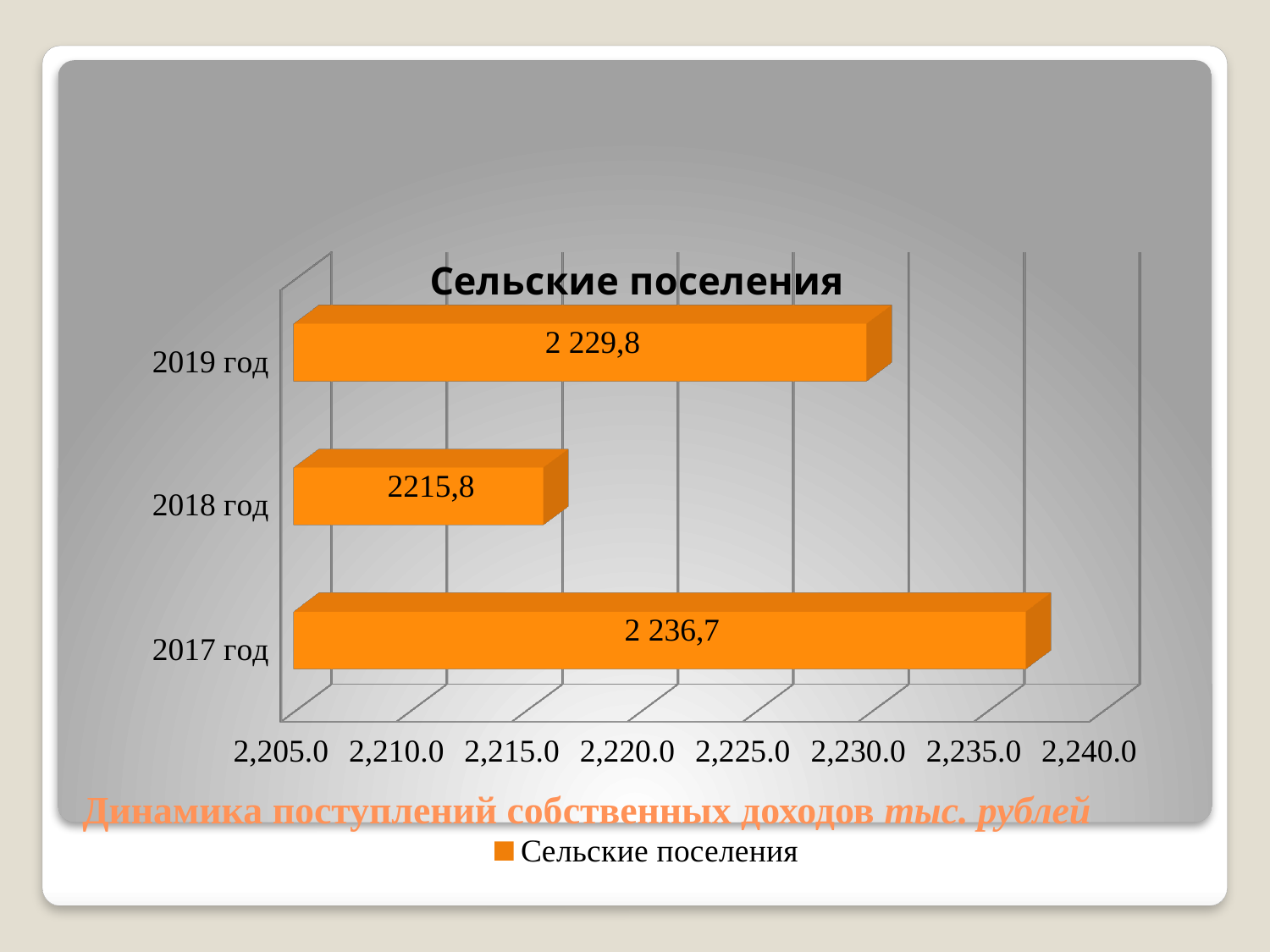
What is the value for 2019 год in the chart? 2 229,8 What is the title of the chart? Сельские поселения Which year has the lowest value in the chart? 2018 год What is the value for 2018 год in the chart? 2215,8 What is the difference between the values for 2019 год and 2018 год? 14,0 What type of chart is shown on the slide? bar chart Which year has the highest value in the chart? 2017 год How many years (categories) are shown in the chart? 3 What is the difference between the values for 2017 год and 2019 год? 6,9 Is the value for 2018 год greater or less than 2,220.0? less Which is larger, the value for 2019 год or the value for 2018 год? 2019 год What is the value for 2017 год in the chart? 2 236,7